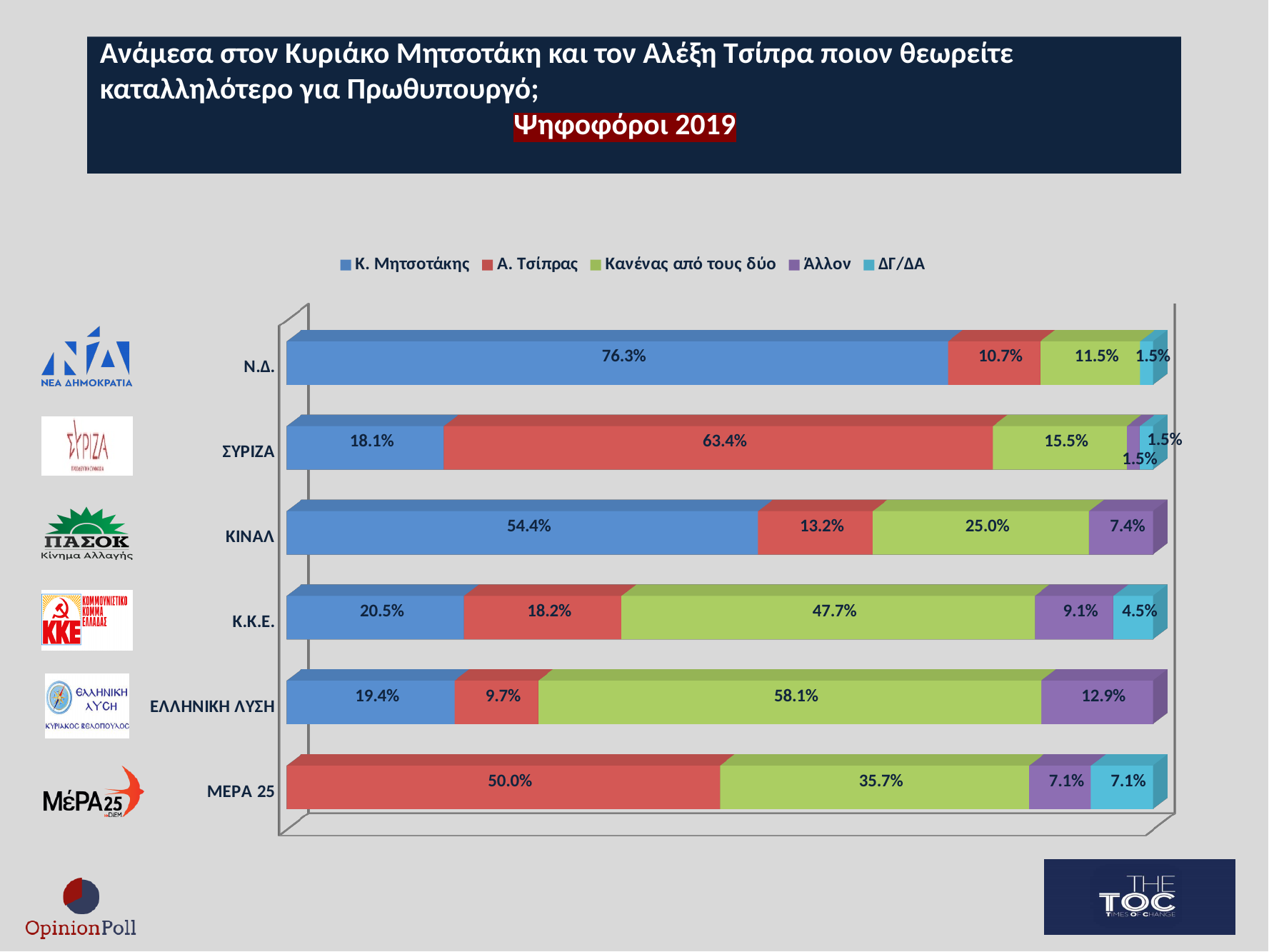
Which party's voters have the lowest value for Α. Τσίπρας? ΕΛΛΗΝΙΚΗ ΛΥΣΗ What is the value for Άλλον among Κ.Κ.Ε. voters? 9.1% What is the difference between the Κ. Μητσοτάκης value for Ν.Δ. voters and for ΚΙΝΑΛ voters? 21.9% How many party categories are shown on the chart? 6 Which series is shown in green in the legend? Κανένας από τους δύο What kind of chart is shown on the slide? Stacked bar chart Which party's voters have the highest value for Κ. Μητσοτάκης? Ν.Δ. Among Κ.Κ.Ε. voters, which is larger: the value for Κ. Μητσοτάκης or for Α. Τσίπρας? Κ. Μητσοτάκης How many series does the legend list? 5 What is the value for Κανένας από τους δύο among ΕΛΛΗΝΙΚΗ ΛΥΣΗ voters? 58.1% What is the value for Α. Τσίπρας among ΣΥΡΙΖΑ voters? 63.4% What is the value for Κ. Μητσοτάκης among Ν.Δ. voters? 76.3%